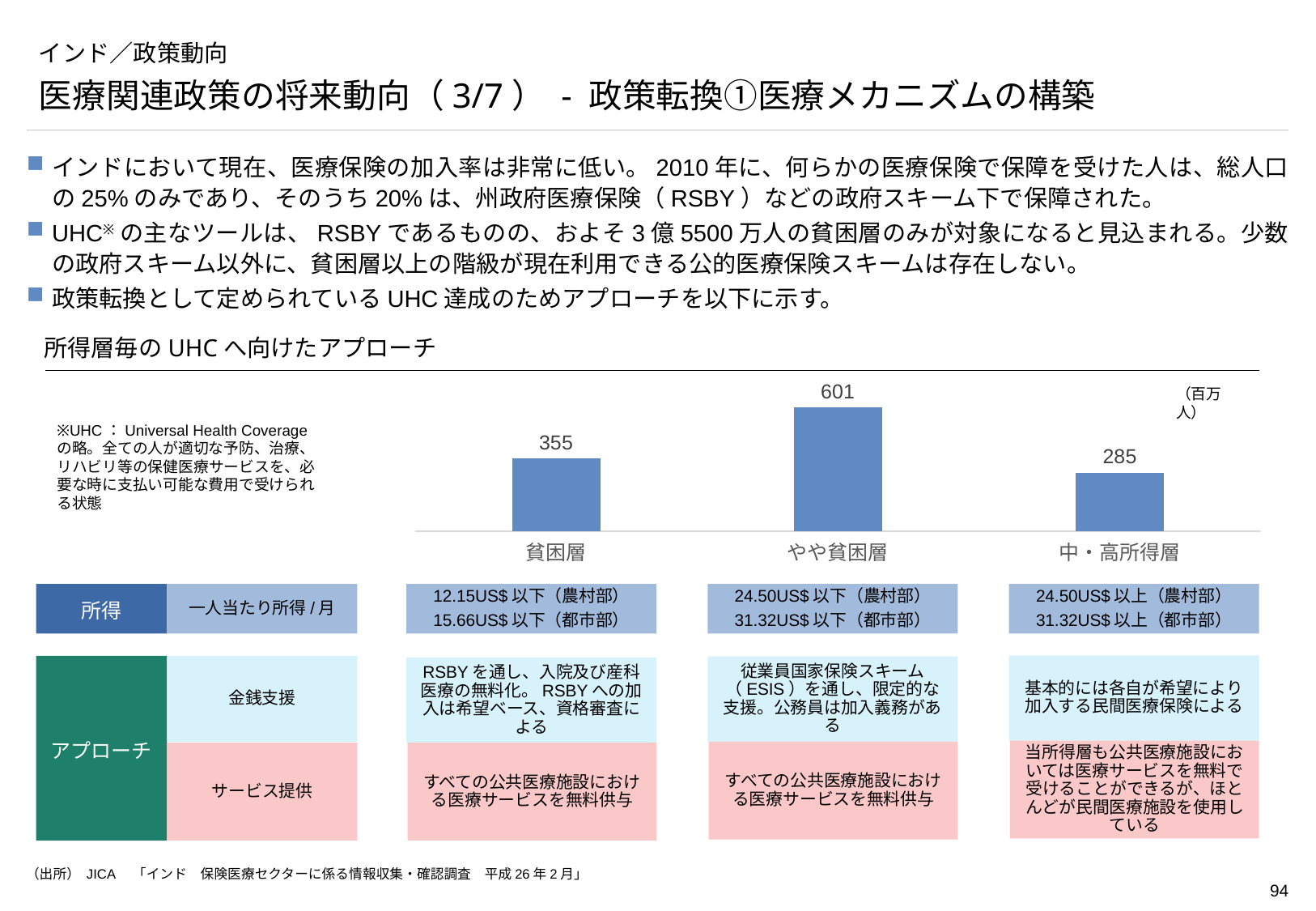
What is the value for やや貧困層 in the bar chart? 601 What is the value for 貧困層 in the bar chart? 355 What kind of chart is shown on the slide? bar chart What is the difference between the values for 貧困層 and 中・高所得層? 70 Which category has the highest value in the bar chart? やや貧困層 How many categories are shown in the bar chart? 3 Which is larger, the value for 貧困層 or the value for 中・高所得層? 貧困層 What unit is indicated for the values in the bar chart? 百万人 Which category has the lowest value in the bar chart? 中・高所得層 What is the difference between the values for やや貧困層 and 貧困層? 246 What is the value for 中・高所得層 in the bar chart? 285 What is the total of the three values shown in the bar chart? 1241